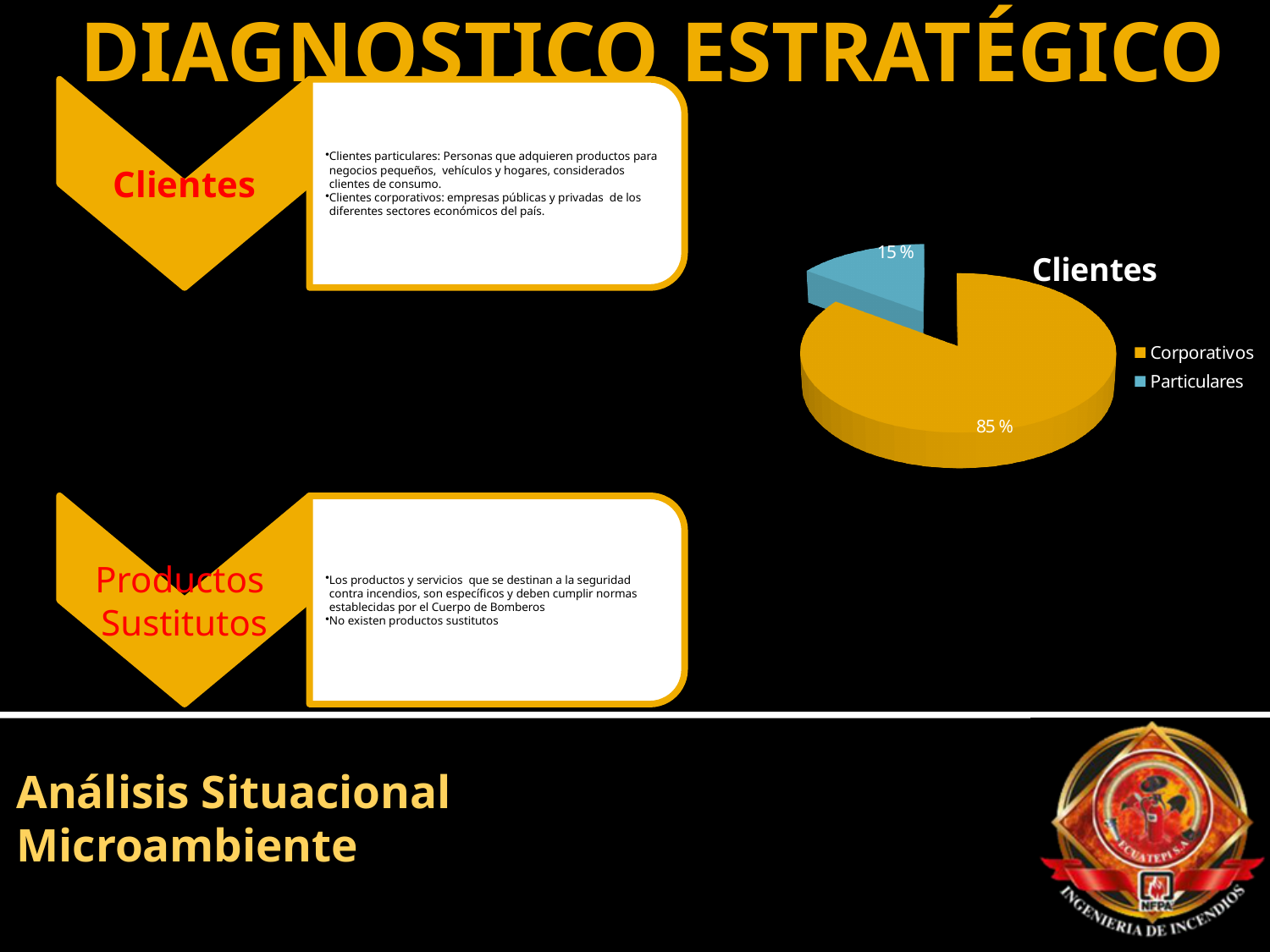
How many entries does the legend of the 'Clientes' pie chart list? 2 What colour is the Particulares slice in the 'Clientes' pie chart? blue What kind of chart is the 'Clientes' chart? pie chart Which category has the largest slice in the 'Clientes' pie chart? Corporativos What is the value for Particulares in the 'Clientes' pie chart? 15 % Which category has the smallest slice in the 'Clientes' pie chart? Particulares What is the title of the pie chart on the slide? Clientes Which is larger in the 'Clientes' pie chart, Corporativos or Particulares? Corporativos What is the value for Corporativos in the 'Clientes' pie chart? 85 % How many slices does the 'Clientes' pie chart have? 2 What is the difference between the Corporativos and Particulares values in the 'Clientes' pie chart? 70 %